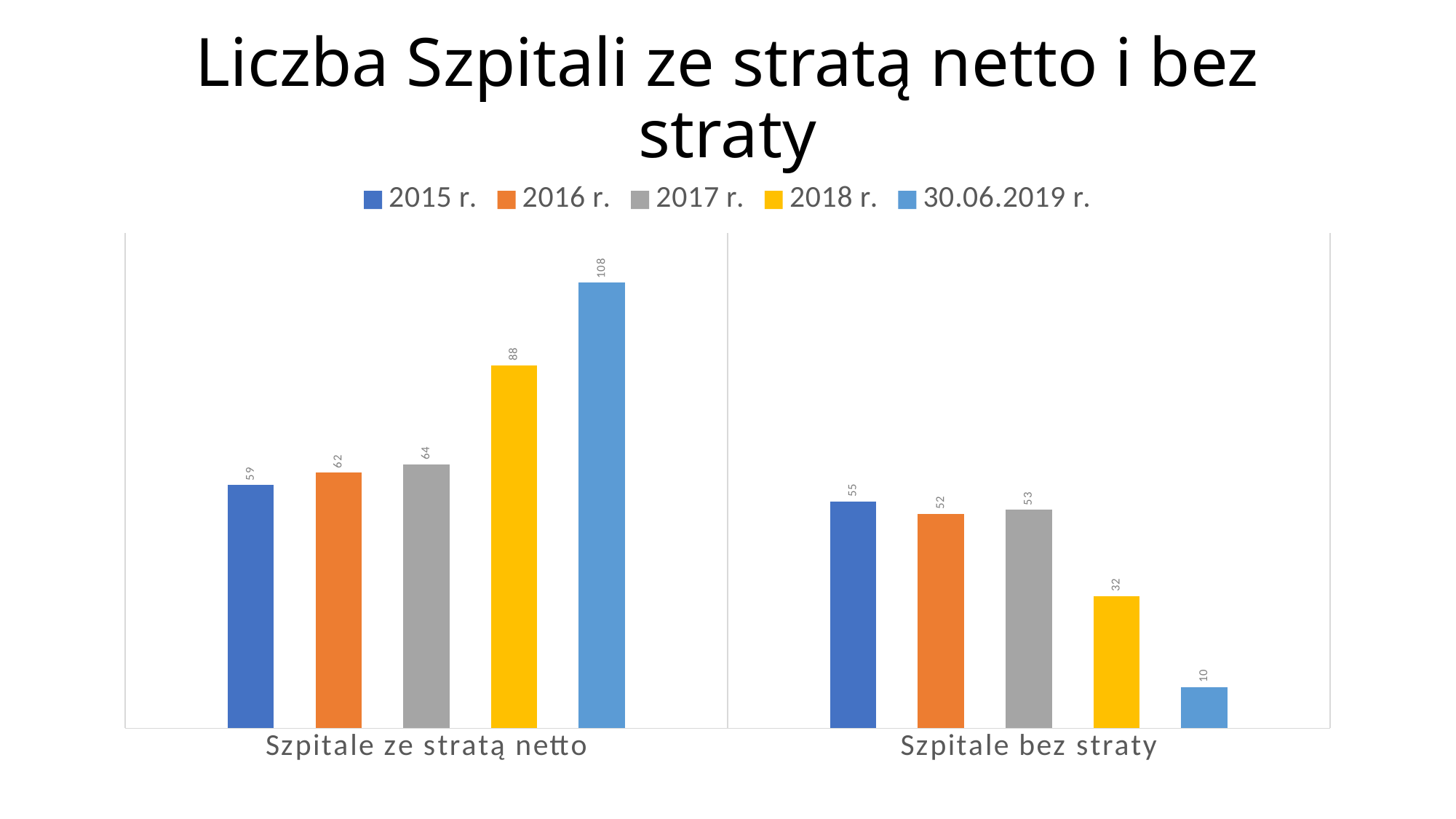
Which series has the lowest value in the Szpitale bez straty category? 30.06.2019 r. What kind of chart is shown on the slide? Bar chart What is the difference between the 2015 r. values for Szpitale ze stratą netto and Szpitale bez straty? 4 Which is larger: the 2017 r. value for Szpitale ze stratą netto or for Szpitale bez straty? Szpitale ze stratą netto What is the value for 30.06.2019 r. in the Szpitale bez straty category? 10 What is the difference between the 30.06.2019 r. and 2018 r. values in the Szpitale ze stratą netto category? 20 What is the value for 2018 r. in the Szpitale ze stratą netto category? 88 What is the value for 2015 r. in the Szpitale ze stratą netto category? 59 How many categories are shown on the x axis? 2 Which series has the highest value in the Szpitale ze stratą netto category? 30.06.2019 r. What is the title of the chart? Liczba Szpitali ze stratą netto i bez straty How many series does the legend list? 5